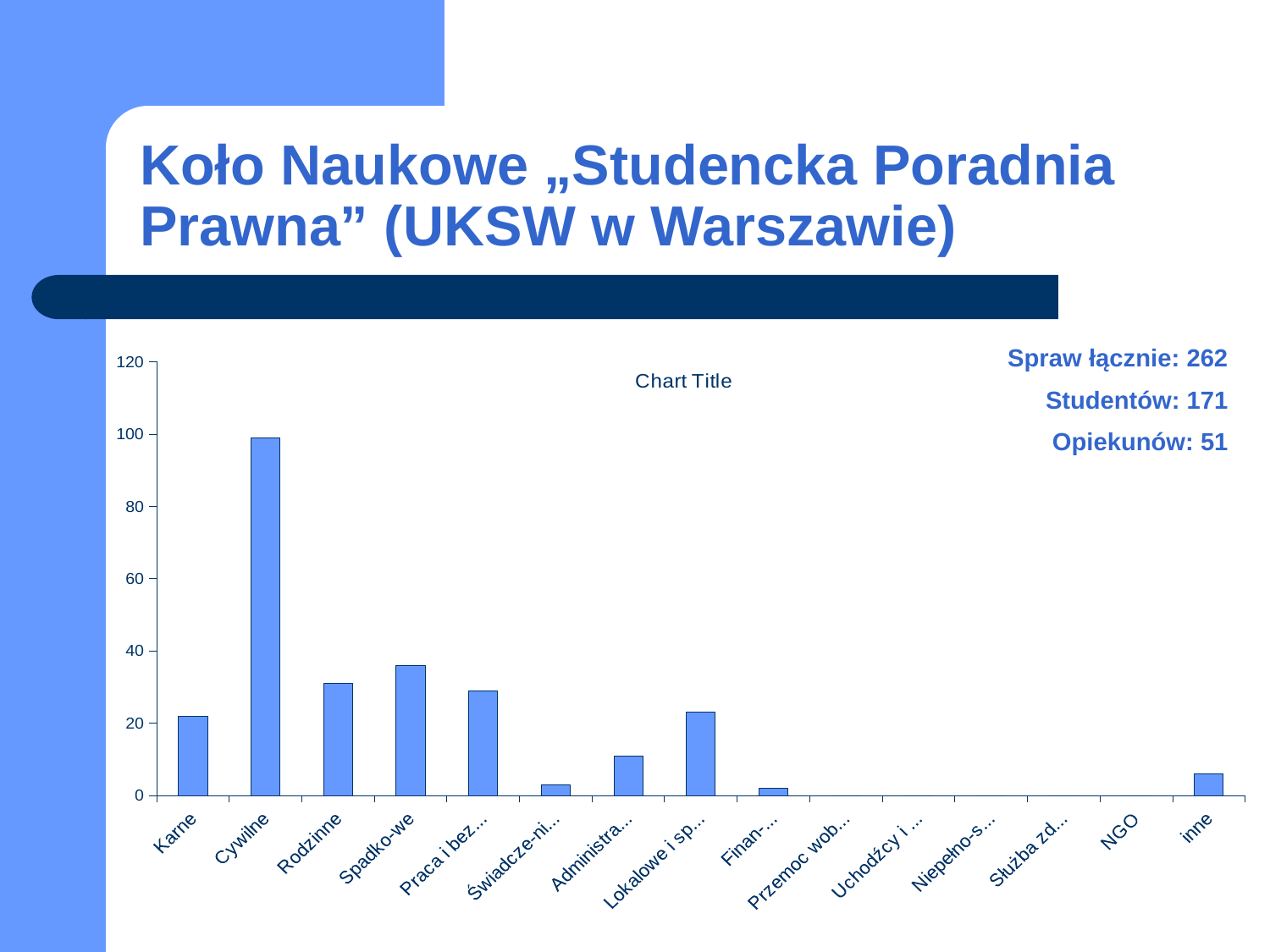
Which is larger, the value for Spadkowe or the value for Karne? Spadkowe Which is larger, the value for Administra... or the value for inne? Administra... How many categories are shown on the x axis of the chart? 15 Which category has the highest bar in the chart? Cywilne Is the value for Karne greater or less than 40? less Which is larger, the value for Cywilne or the value for Karne? Cywilne What kind of chart is shown on the slide? bar chart Is the value for Cywilne greater or less than 80? greater Is the value for Rodzinne greater or less than 20? greater What is the title shown on the chart? Chart Title